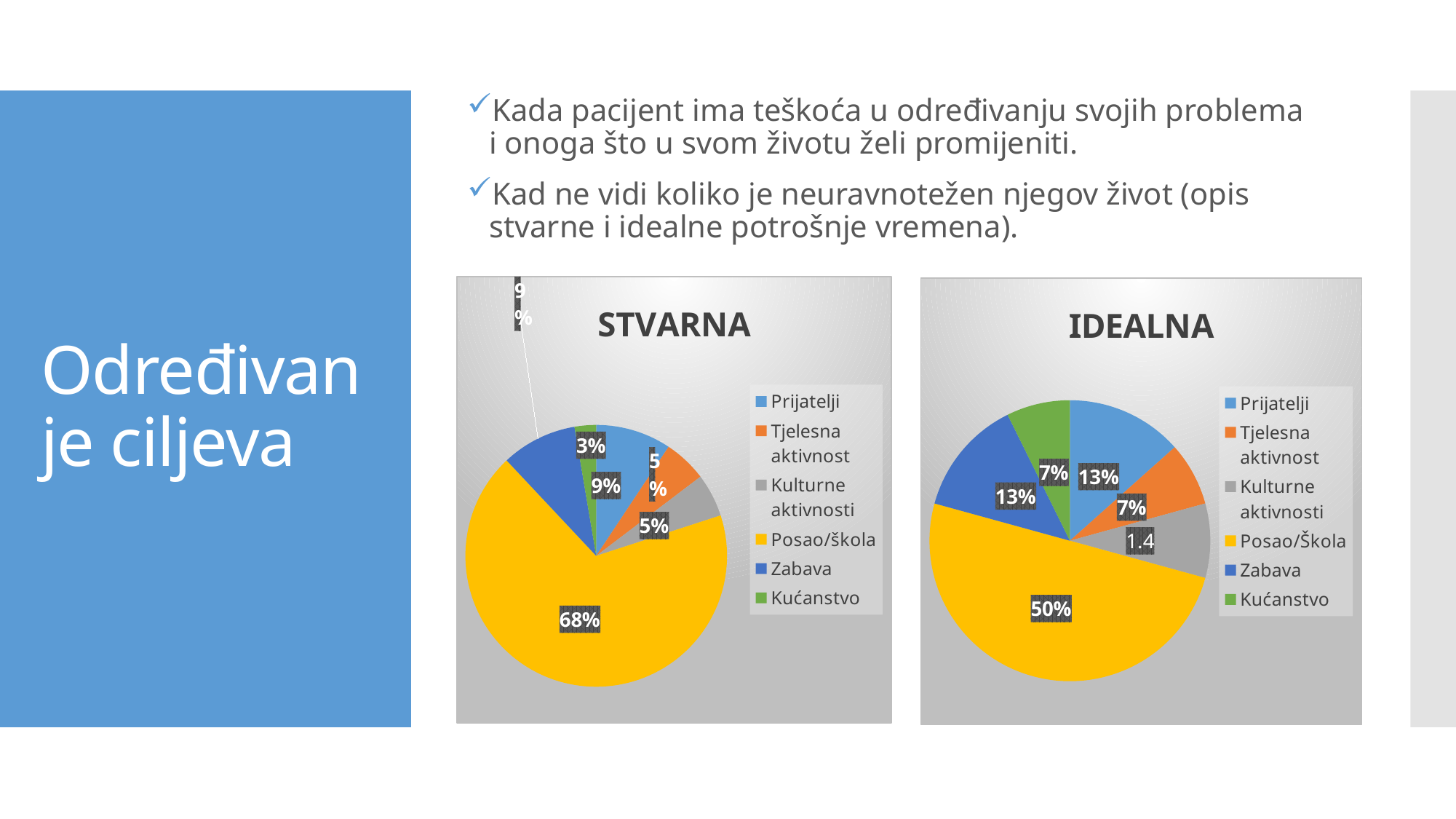
In the IDEALNA chart, which is larger, Zabava or Kućanstvo? Zabava In the STVARNA chart, what share does Posao/škola have? 68% In the IDEALNA chart, what is the value for Prijatelji? 13% What type of chart is the IDEALNA chart? Pie chart What is the difference between the Posao/škola share in the STVARNA chart and the Posao/Škola share in the IDEALNA chart? 18% In the STVARNA chart, what is the value for Kućanstvo? 3% In the STVARNA chart, which category has the largest slice? Posao/škola In the IDEALNA chart, what share does Posao/Škola have? 50% In the STVARNA chart, what colour is the Posao/škola slice? Yellow How many categories does the legend of the STVARNA chart list? 6 In the STVARNA chart, which category has the smallest slice? Kućanstvo In the IDEALNA chart, which category has the largest slice? Posao/Škola